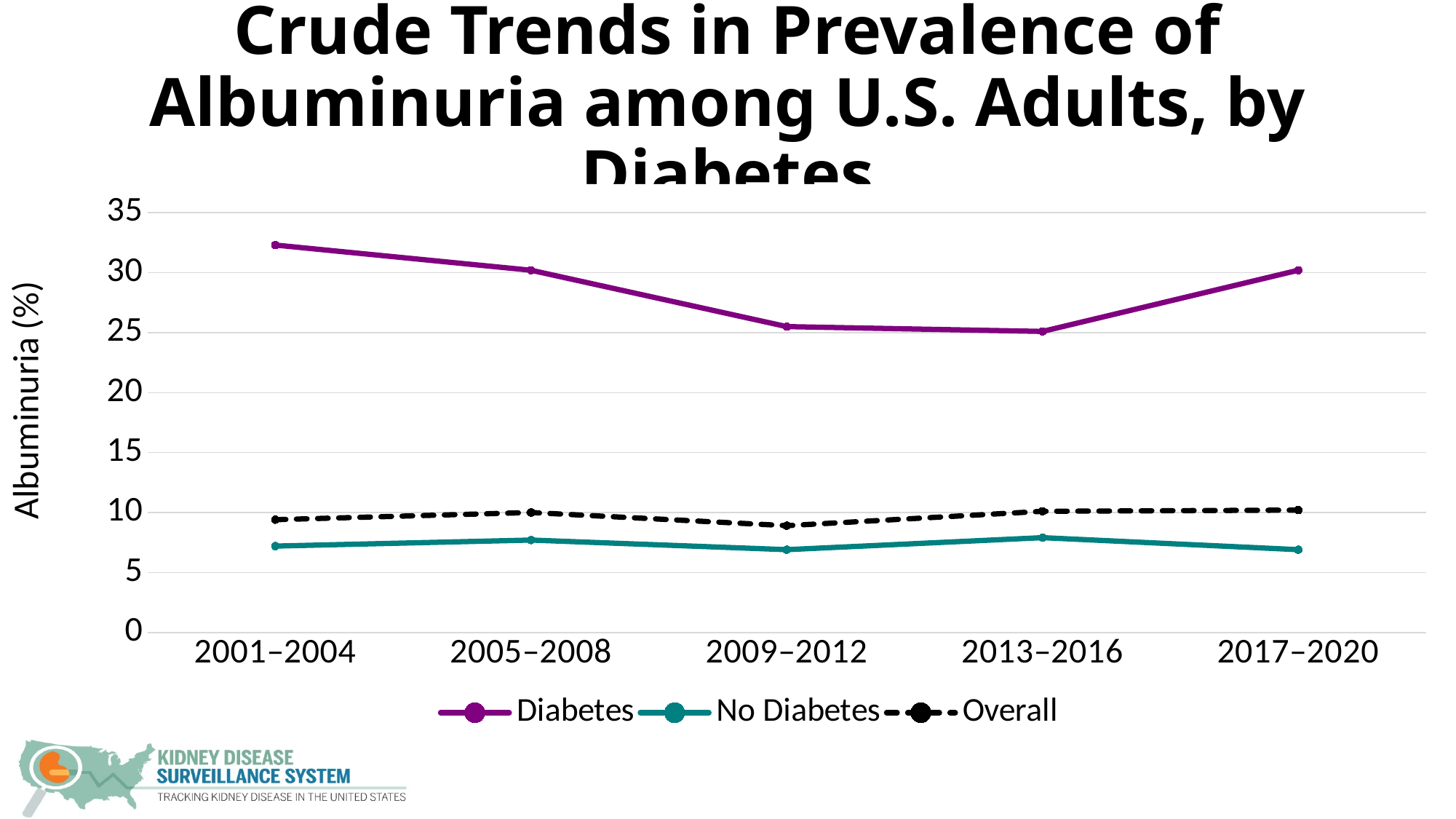
How many series does the legend list? 3 Is the value for No Diabetes in 2001–2004 greater or less than 10? less Is the value for Diabetes in 2013–2016 greater or less than 30? less Which series has the larger value in 2017–2020, Diabetes or No Diabetes? Diabetes Which series has the larger value in 2005–2008, Overall or No Diabetes? Overall What is the label on the y axis? Albuminuria (%) In which period is the Diabetes series at its highest? 2001–2004 Is the value for Overall in 2009–2012 greater or less than 10? less Does the Diabetes series rise or fall from 2001–2004 to 2013–2016? fall What kind of chart is shown on the slide? line chart How many time periods are shown on the x axis? 5